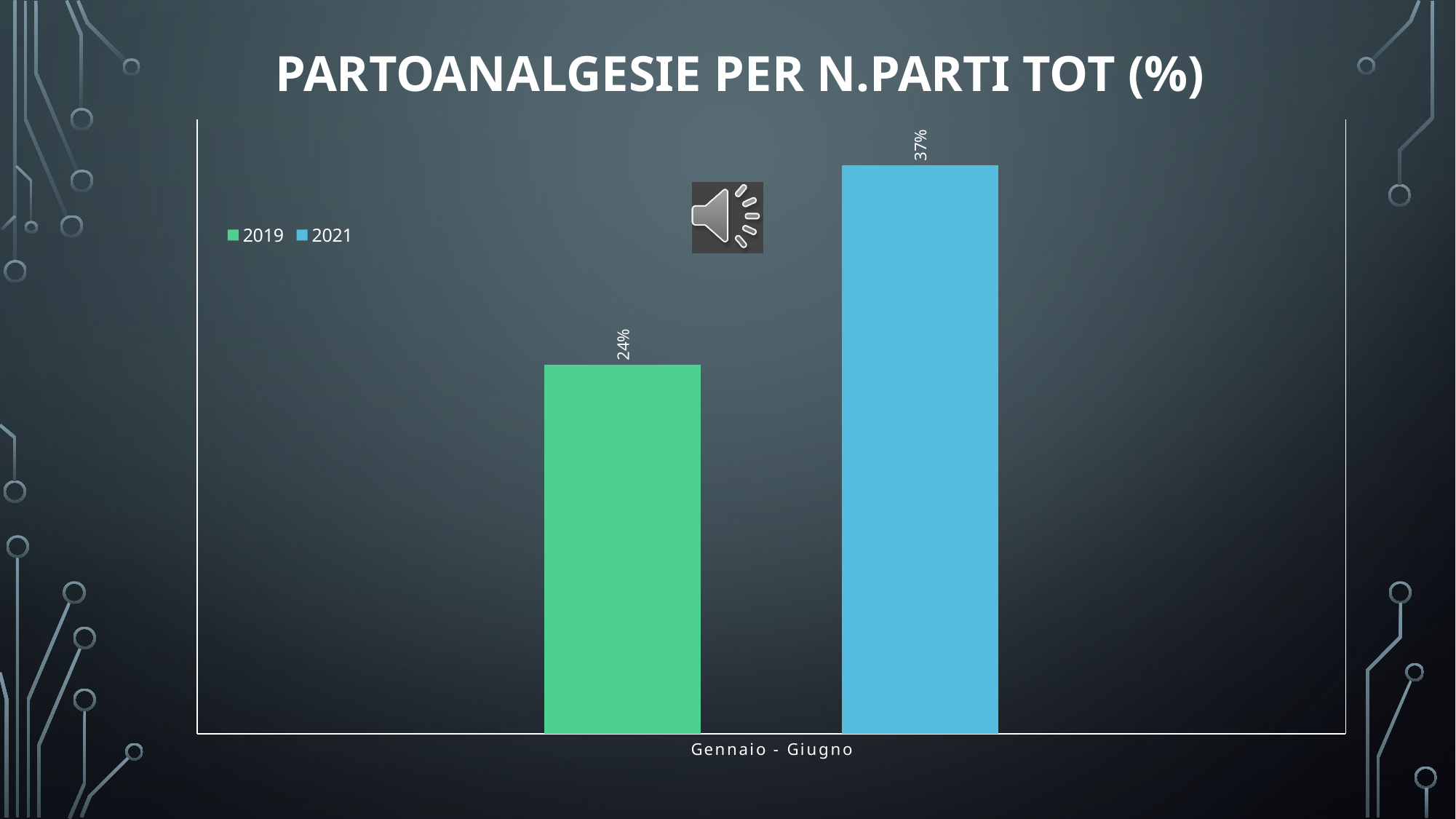
Which series has the higher value, 2019 or 2021? 2021 Which series has the highest value on the chart? 2021 What is the value for 2021 in the Gennaio - Giugno period? 37% Which series has the lowest value on the chart? 2019 What kind of chart is shown on the slide? Bar chart What is the difference between the 2021 value and the 2019 value? 13% What is the value for 2019 in the Gennaio - Giugno period? 24% How many series does the legend list? 2 What is the title of the chart? PARTOANALGESIE PER N.PARTI TOT (%) What is the category label on the x axis? Gennaio - Giugno How many categories are shown on the x axis? 1